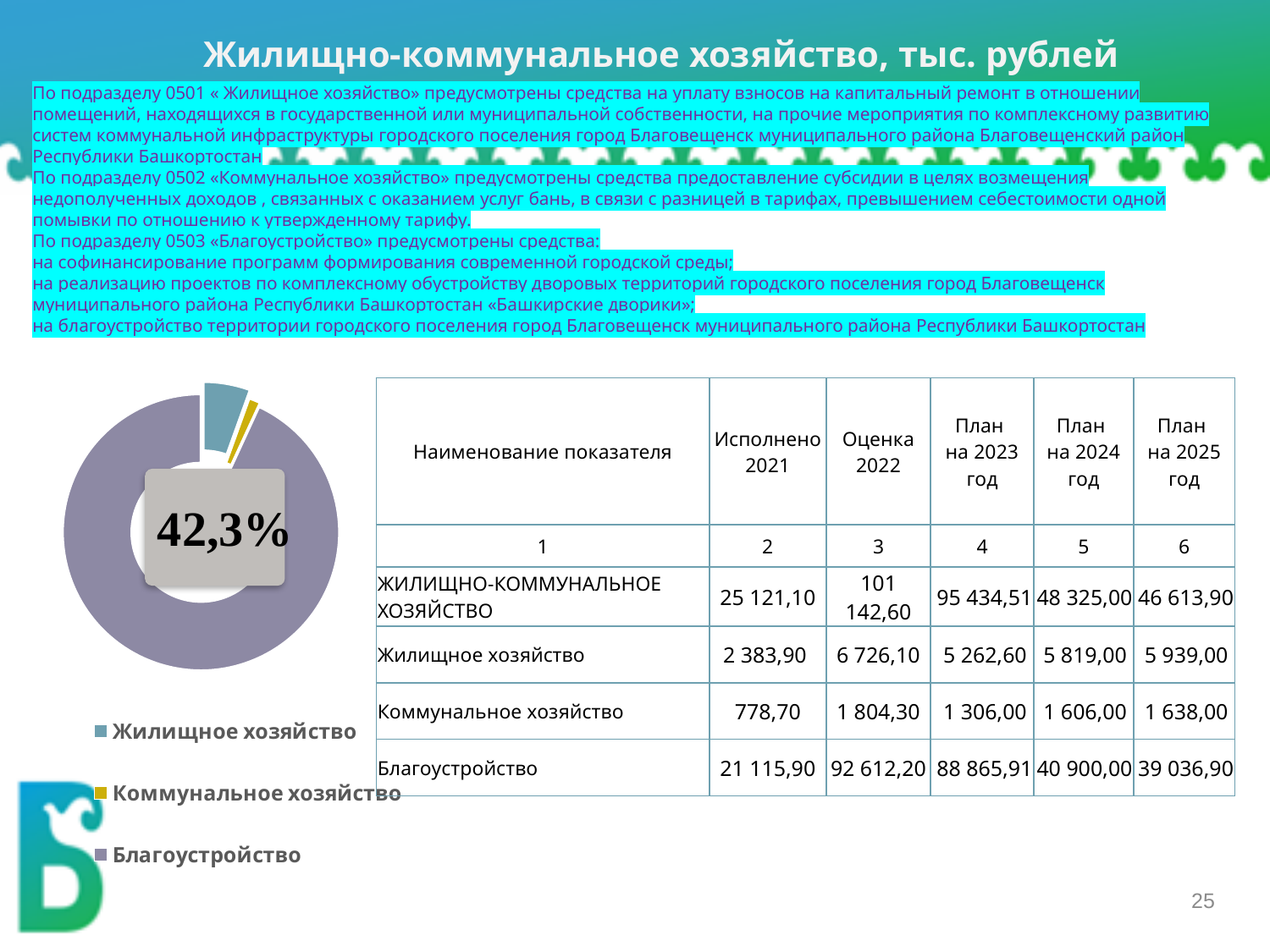
Which category has the smallest slice in the doughnut chart? Коммунальное хозяйство In the doughnut chart, which slice is larger: Благоустройство or Жилищное хозяйство? Благоустройство Which category has the largest slice in the doughnut chart? Благоустройство How many entries does the legend of the doughnut chart list? 3 In the doughnut chart, which slice is larger: Жилищное хозяйство or Коммунальное хозяйство? Жилищное хозяйство What percentage value is displayed in the centre of the doughnut chart? 42,3% How many categories does the doughnut chart show? 3 Which colour represents Благоустройство in the doughnut chart? Purple What kind of chart is shown on the slide? Doughnut (pie) chart